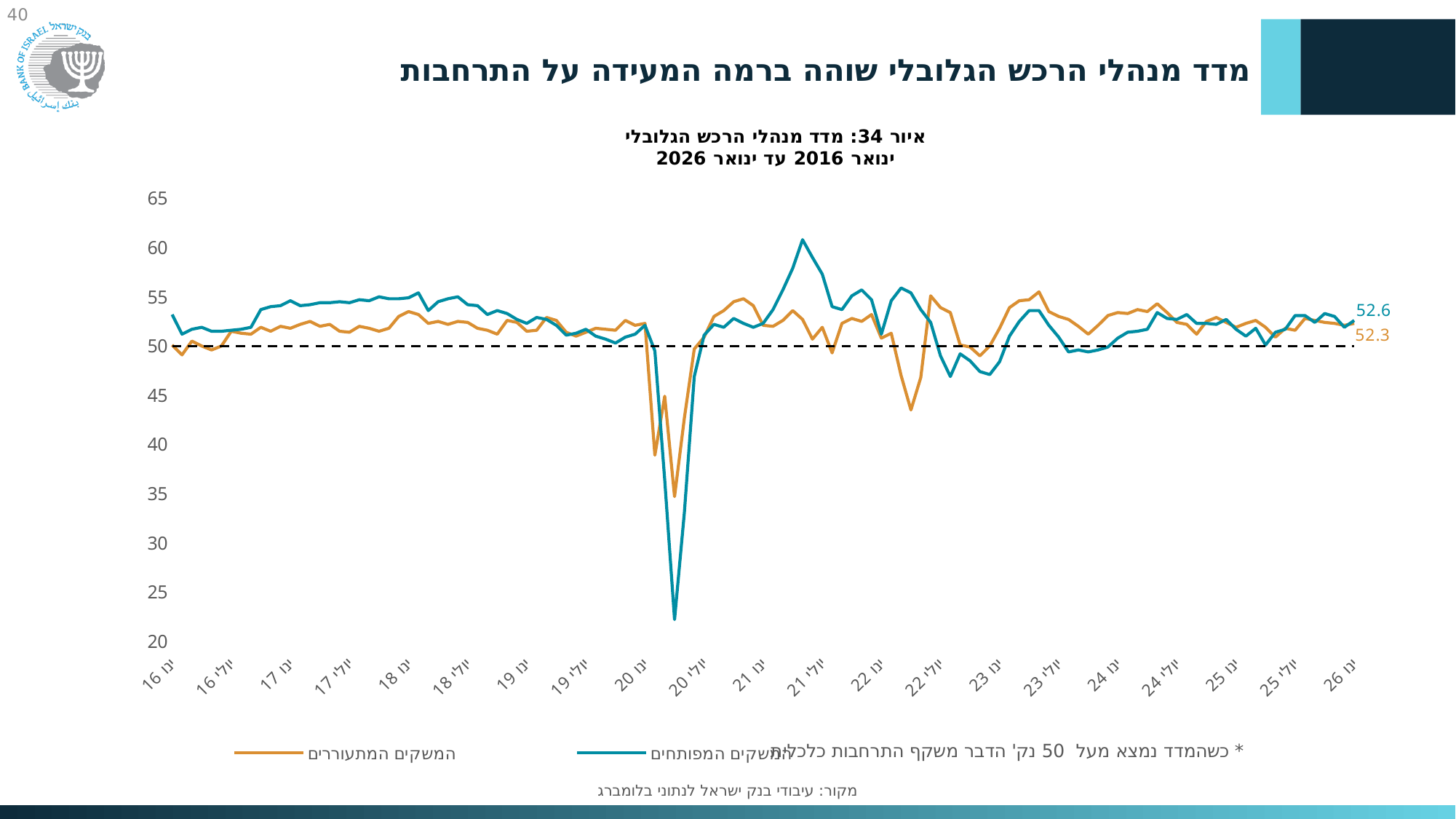
Is the lowest value of the emerging economies (המשקים המתעוררים) series, reached around 2020, greater or less than 40? less At what level is the horizontal dashed reference line drawn? 50 What is the latest value shown for the emerging economies (המשקים המתעוררים) series? 52.3 Is the peak of the developed economies (המשקים המפותחים) series around mid-2021 greater or less than 60? greater How many series does the legend list? 2 What kind of chart is shown on the slide? Line chart Is the lowest value of the developed economies (המשקים המפותחים) series, reached around 2020, greater or less than 25? less What is the difference between the final values of the developed economies series (52.6) and the emerging economies series (52.3)? 0.3 Which series reaches the lower value during the 2020 dip, developed economies (המשקים המפותחים) or emerging economies (המשקים המתעוררים)? המשקים המפותחים Which series has the higher final value, developed economies (המשקים המפותחים) or emerging economies (המשקים המתעוררים)? המשקים המפותחים What period does the chart title say the data covers? ינואר 2016 עד ינואר 2026 What is the latest value shown for the developed economies (המשקים המפותחים) series? 52.6